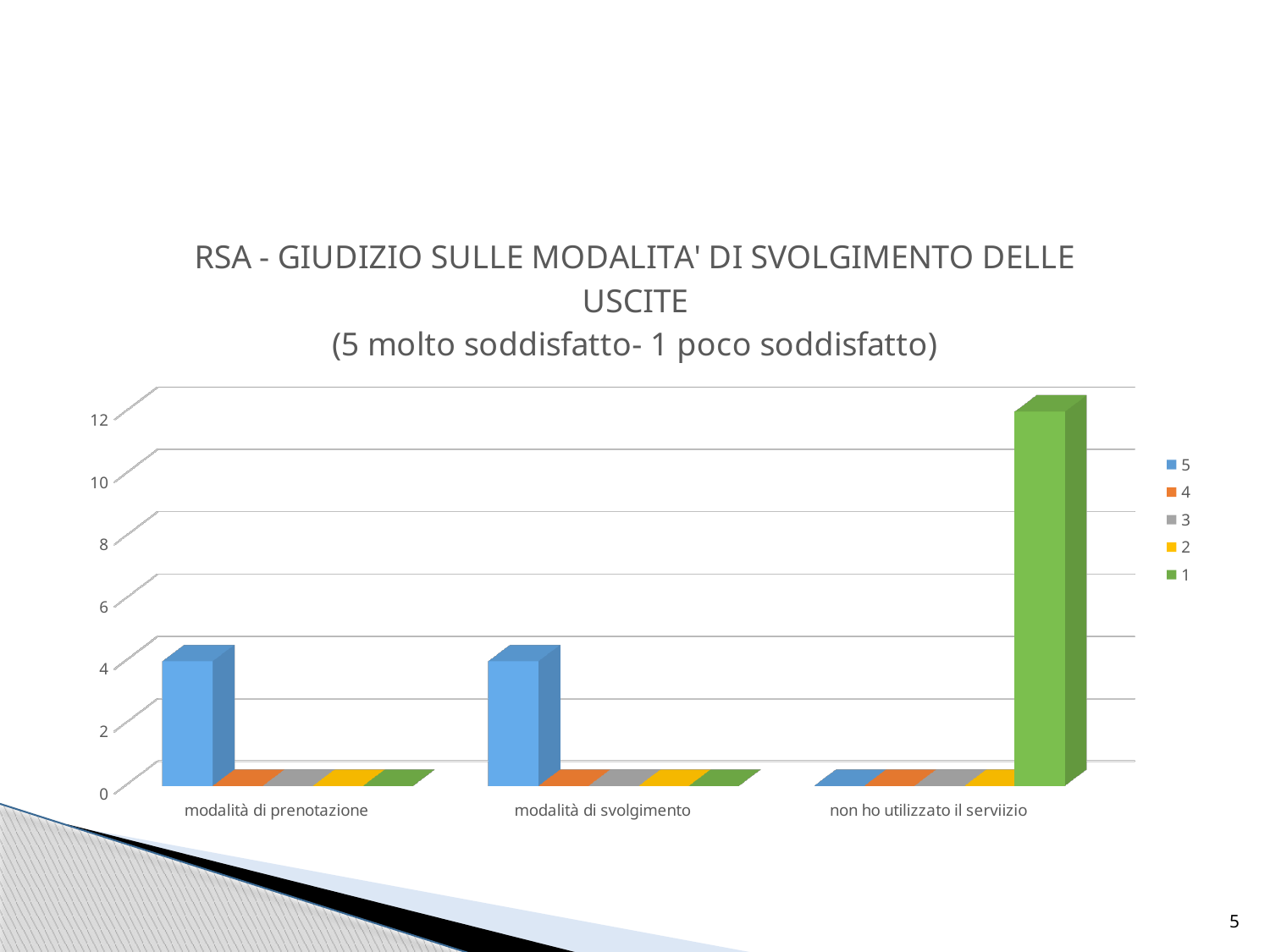
What is the value of series 5 for the category 'non ho utilizzato il serviizio'? 0 Is the value of series 5 for 'modalità di svolgimento' greater or less than 6? less Which legend entry is shown in green? 1 Is the value of series 5 for 'modalità di prenotazione' greater or less than 2? greater Which is larger: the series 1 bar for 'non ho utilizzato il serviizio' or the series 5 bar for 'modalità di prenotazione'? series 1 bar for 'non ho utilizzato il serviizio' Which series has the tallest bar for the category 'modalità di prenotazione'? 5 Is the value of series 1 for 'non ho utilizzato il serviizio' greater or less than 10? greater Which category has the tallest bar in the chart? non ho utilizzato il serviizio Which series has the tallest bar for the category 'non ho utilizzato il serviizio'? 1 How many categories are shown on the x axis of the chart? 3 What kind of chart is shown on the slide? bar chart How many series does the chart's legend list? 5